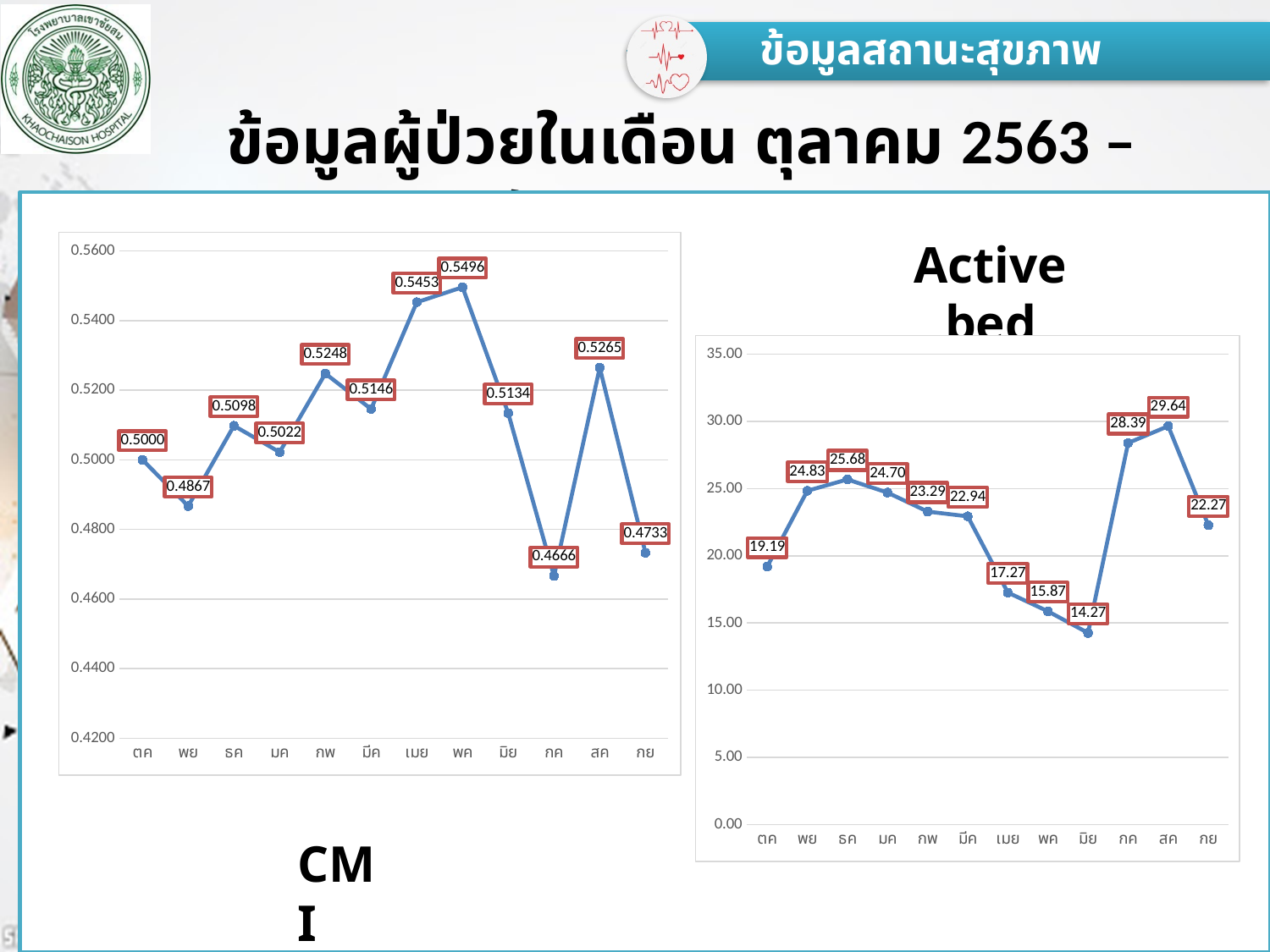
In the CMI chart on the left, which month has the highest value? พค In the Active bed chart on the right, do the values rise or fall from ธค to มิย? Fall In the CMI chart on the left, how many data points are plotted? 12 In the CMI chart on the left, what is the difference between the values for สค and กย? 0.0532 In the Active bed chart on the right, which month has the highest value? สค In the Active bed chart on the right, what is the difference between the values for สค and กค? 1.25 In the Active bed chart on the right, what is the value for มิย? 14.27 In the Active bed chart on the right, which is larger, the value for ตค or the value for พย? พย In the Active bed chart on the right, which month has the lowest value? มิย In the CMI chart on the left, what is the value for พค? 0.5496 What kind of chart is the Active bed chart on the right? Line chart In the CMI chart on the left, which month has the lowest value? กค